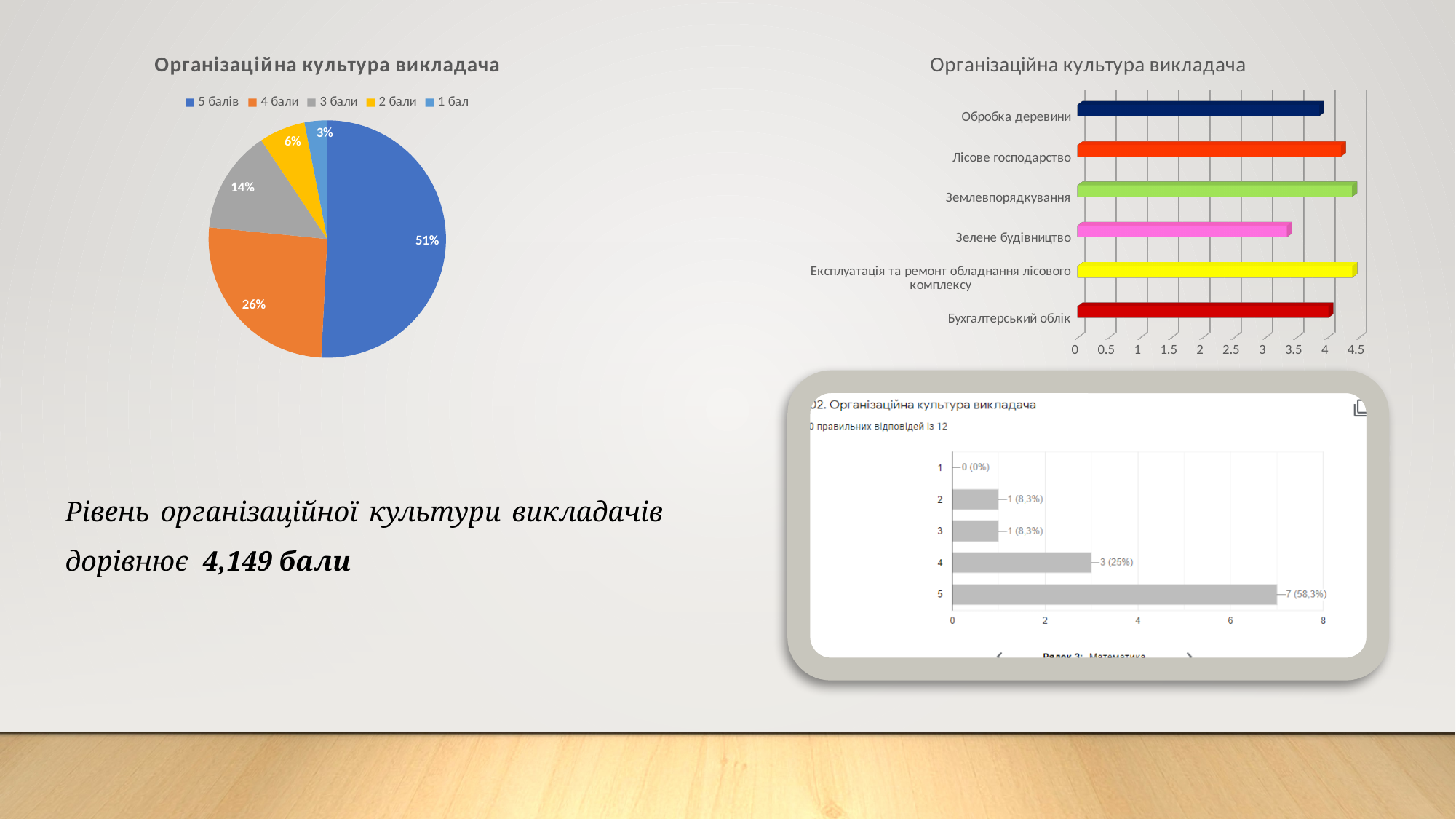
In the pie chart on the top left, what is the difference in percentage points between the '3 бали' slice and the '2 бали' slice? 8 In the bar chart on the top right, is the value for 'Лісове господарство' greater or less than 4? greater In the pie chart on the top left, what percentage is shown for '4 бали'? 26% In the bar chart on the bottom right, what is the value shown for category 5? 7 (58,3%) In the bar chart on the bottom right, which category has the highest value? 5 In the pie chart on the top left, which legend category has the smallest slice? 1 бал In the bar chart on the top right, is the value for 'Зелене будівництво' greater or less than 4? less In the pie chart on the top left, how many entries does the legend list? 5 In the bar chart on the top right, which category has the lowest value? Зелене будівництво In the bar chart on the top right, how many categories are plotted? 6 What kind of chart is the one on the top right of the slide? bar chart In the pie chart on the top left, what share does the '5 балів' slice have? 51%